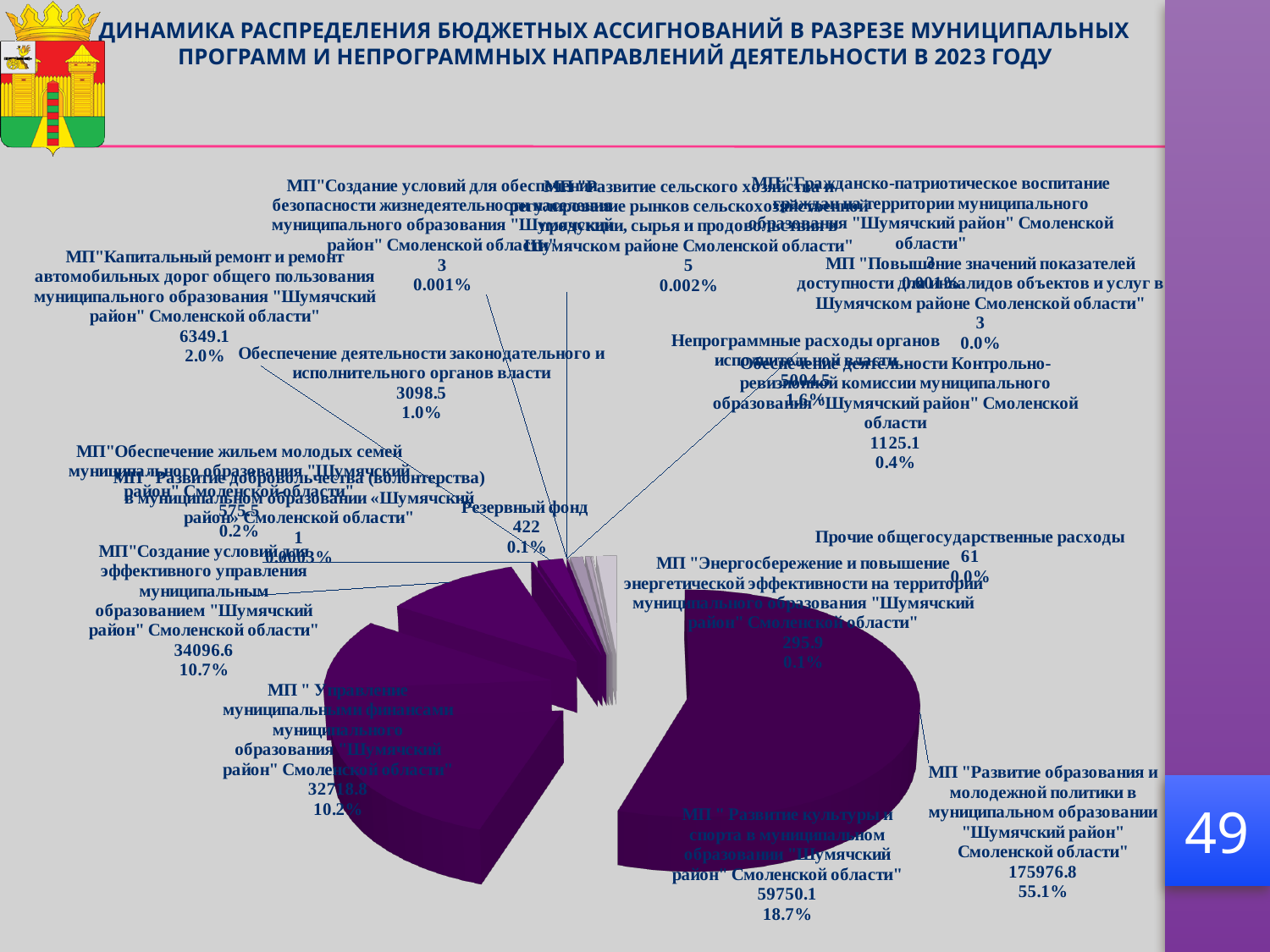
Which is larger: the value for МП "Создание условий для эффективного управления муниципальным образованием" or the value for МП "Капитальный ремонт и ремонт автомобильных дорог"? МП "Создание условий для эффективного управления муниципальным образованием" What percentage is shown for МП "Развитие культуры и спорта"? 18.7% What is the value shown for Прочие общегосударственные расходы? 61 What is the value shown for Резервный фонд? 422 What is the value shown for МП "Создание условий для эффективного управления муниципальным образованием "Шумячский район" Смоленской области"? 34096.6 Which category has the largest share of the pie? МП "Развитие образования и молодежной политики в муниципальном образовании "Шумячский район" Смоленской области" What is the value shown for МП "Капитальный ремонт и ремонт автомобильных дорог общего пользования"? 6349.1 What kind of chart is shown on the slide? pie chart What is the value shown for МП "Развитие культуры и спорта в муниципальном образовании "Шумячский район" Смоленской области"? 59750.1 What is the difference between the values for МП "Развитие образования и молодежной политики" (175976.8) and МП "Развитие культуры и спорта" (59750.1)? 116226.7 What is the value shown for Обеспечение деятельности законодательного и исполнительного органов власти? 3098.5 What share of the pie does МП "Развитие образования и молодежной политики" have? 55.1%